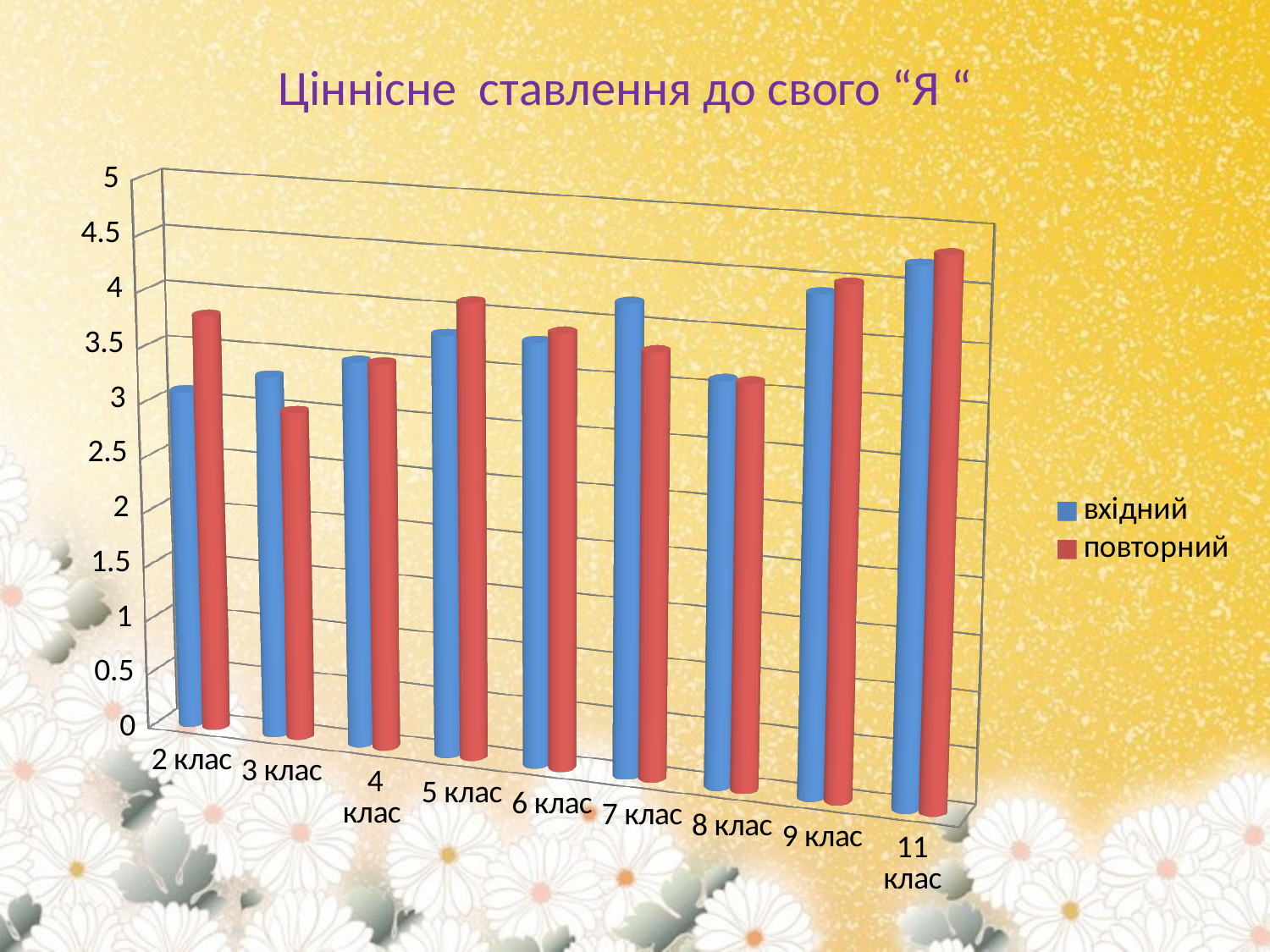
Which series is shown in red? повторний Which class has the highest value for the вхідний series? 11 клас Which class has the highest value for the повторний series? 11 клас How many class categories are shown on the x axis? 9 How many series does the legend list? 2 What is the title of the chart? Ціннісне ставлення до свого “Я “ For 2 клас, which series has the larger value, вхідний or повторний? повторний What kind of chart is shown on the slide? bar chart Is the повторний value for 11 клас greater or less than 4? greater For 3 клас, which series has the larger value, вхідний or повторний? вхідний Which class has the lowest value for the повторний series? 3 клас